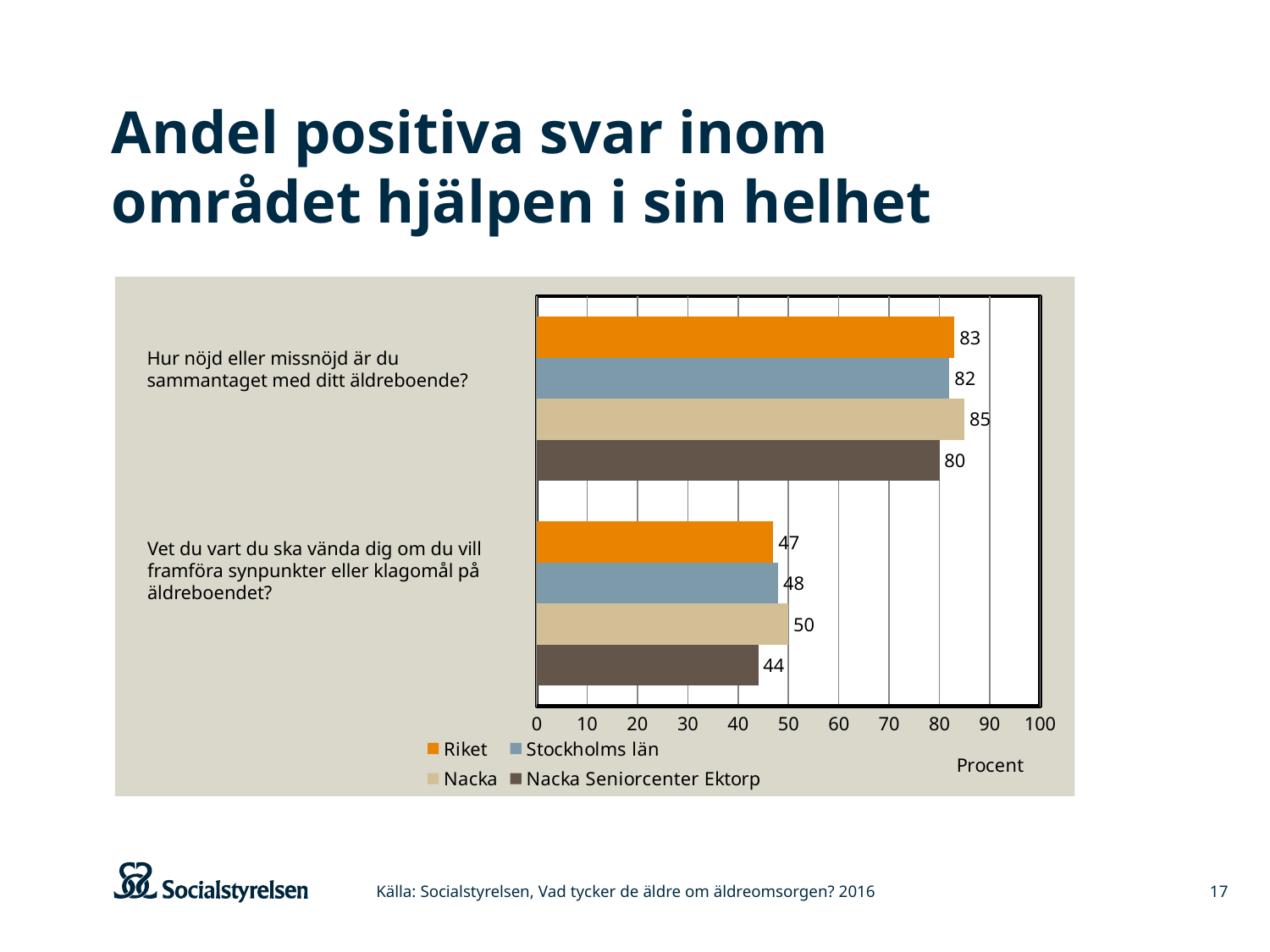
How many question categories are shown on the chart? 2 How many series does the legend list? 4 Which series has the highest value on the question "Hur nöjd eller missnöjd är du sammantaget med ditt äldreboende?"? Nacka Which is larger on the question "Vet du vart du ska vända dig om du vill framföra synpunkter eller klagomål på äldreboendet?": Riket or Nacka? Nacka What is the value for Riket on the question "Hur nöjd eller missnöjd är du sammantaget med ditt äldreboende?"? 83 What unit label is shown on the horizontal axis of the chart? Procent What is the value for Stockholms län on the question "Vet du vart du ska vända dig om du vill framföra synpunkter eller klagomål på äldreboendet?"? 48 What is the value for Nacka Seniorcenter Ektorp on the question "Vet du vart du ska vända dig om du vill framföra synpunkter eller klagomål på äldreboendet?"? 44 Is the value for Nacka Seniorcenter Ektorp on the question "Hur nöjd eller missnöjd är du sammantaget med ditt äldreboende?" greater or less than 70? greater What is the difference between the Nacka value and the Nacka Seniorcenter Ektorp value on the question "Hur nöjd eller missnöjd är du sammantaget med ditt äldreboende?"? 5 Which series has the lowest value on the question "Vet du vart du ska vända dig om du vill framföra synpunkter eller klagomål på äldreboendet?"? Nacka Seniorcenter Ektorp What kind of chart is shown on the slide? Bar chart